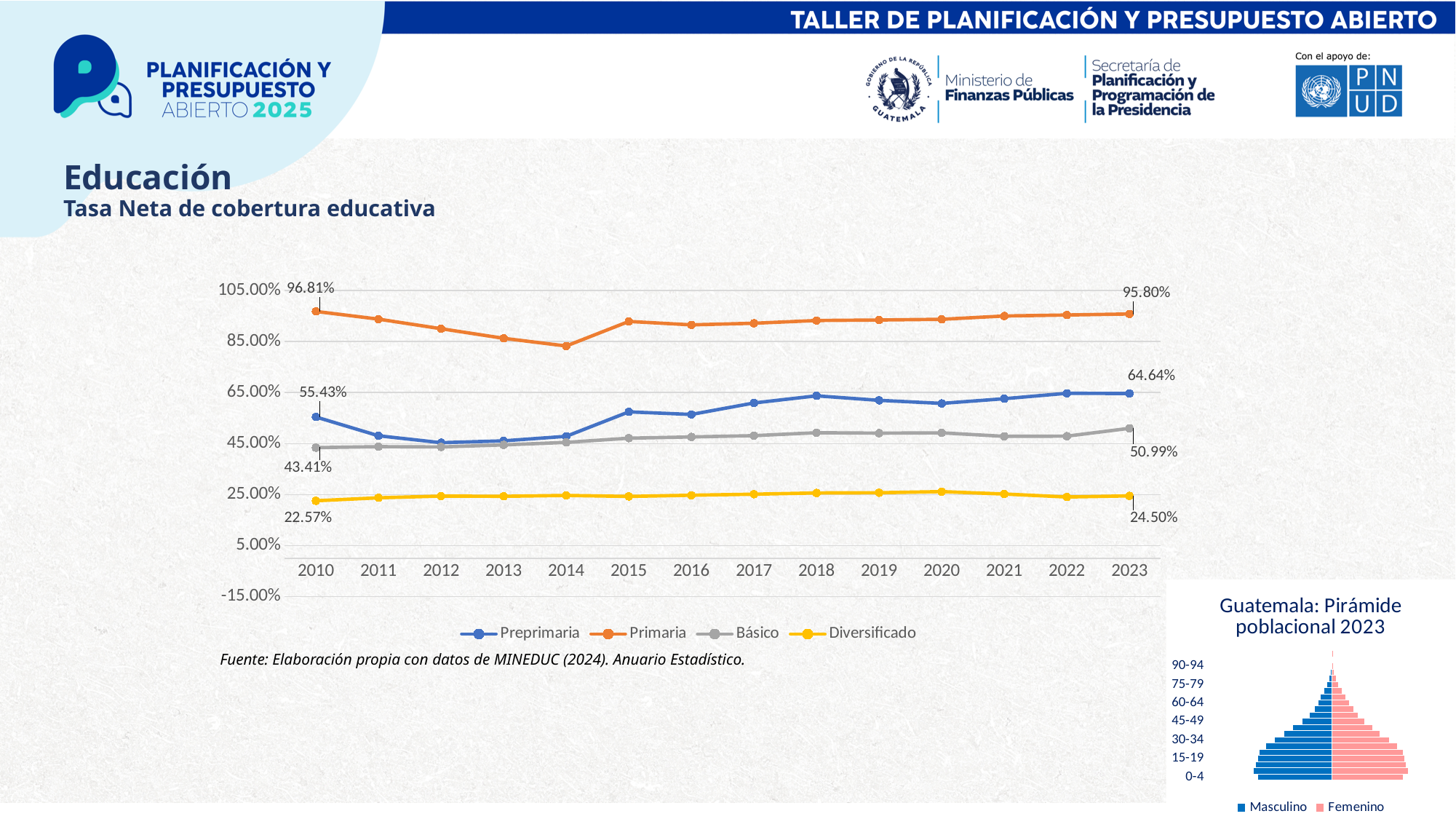
In the line chart 'Tasa Neta de cobertura educativa', does the Preprimaria series rise or fall between 2010 and 2023? rise In the line chart 'Tasa Neta de cobertura educativa', what is the value for Diversificado in 2023? 24.50% In the line chart 'Tasa Neta de cobertura educativa', how many years are shown on the x axis? 14 What kind of chart is 'Guatemala: Pirámide poblacional 2023' in the bottom right of the slide? bar chart In the line chart 'Tasa Neta de cobertura educativa', what is the value for Primaria in 2010? 96.81% In the line chart 'Tasa Neta de cobertura educativa', what is the difference between the Preprimaria values in 2023 and 2010? 9.21% In the line chart 'Tasa Neta de cobertura educativa', which series has the lowest value in 2010? Diversificado In the line chart 'Tasa Neta de cobertura educativa', what is the value for Preprimaria in 2023? 64.64% In the line chart 'Tasa Neta de cobertura educativa', which series has the highest value in 2023? Primaria In the line chart 'Tasa Neta de cobertura educativa', is the Primaria value in 2014 greater or less than 85.00%? less In the line chart 'Tasa Neta de cobertura educativa', how many series does the legend list? 4 In the line chart 'Tasa Neta de cobertura educativa', what is the value for Básico in 2010? 43.41%